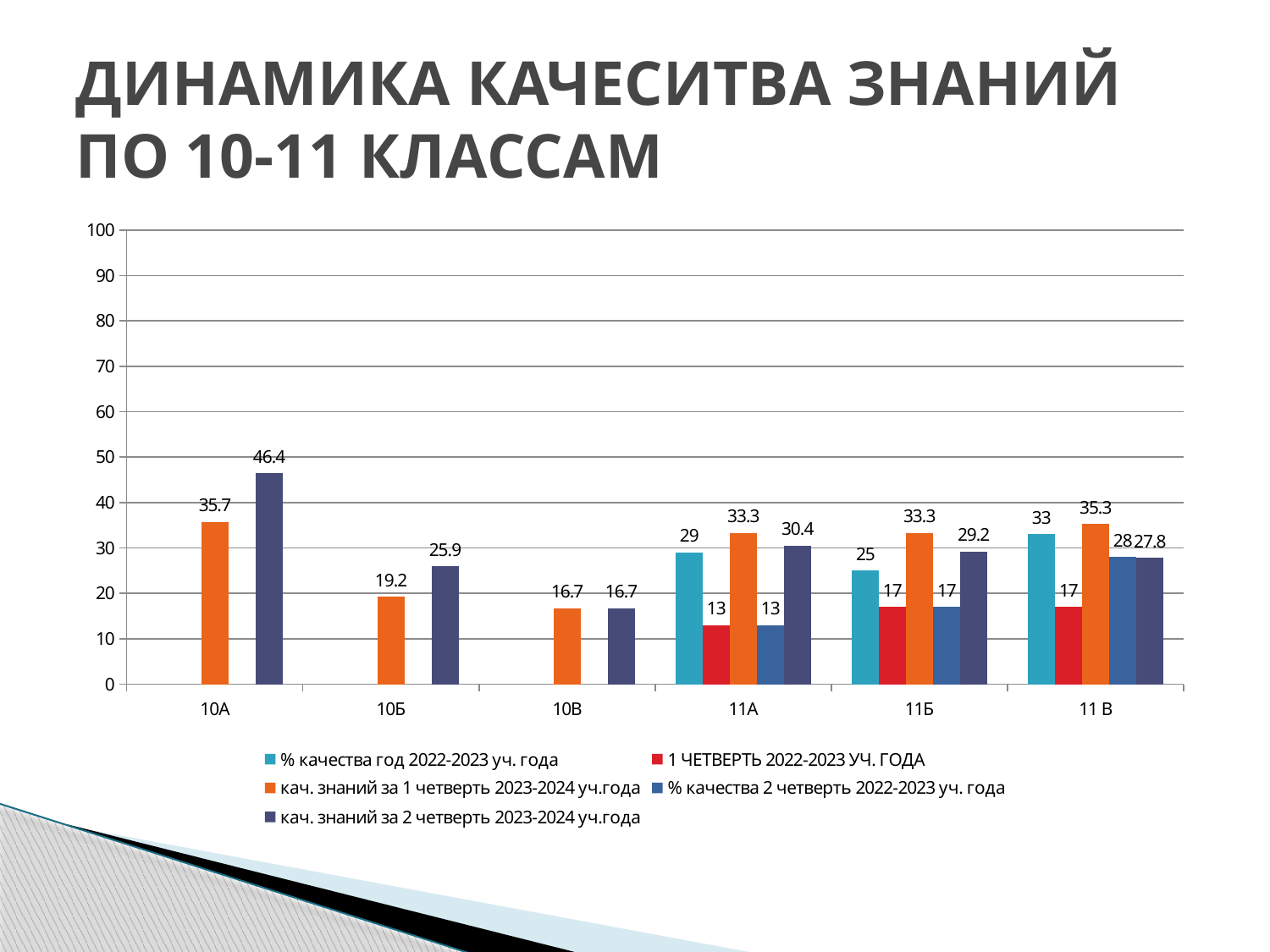
Is the value for 10А in the series 'кач. знаний за 2 четверть 2023-2024 уч.года' greater or less than 40? greater What is the title of the slide? ДИНАМИКА КАЧЕСИТВА ЗНАНИЙ ПО 10-11 КЛАССАМ How many classes are shown on the x axis of the chart? 6 Which class has the lowest value in the series 'кач. знаний за 1 четверть 2023-2024 уч.года'? 10В Which class has the highest value in the series 'кач. знаний за 2 четверть 2023-2024 уч.года'? 10А For 11 В, which is larger: the value for 'кач. знаний за 1 четверть 2023-2024 уч.года' or the value for '% качества год 2022-2023 уч. года'? кач. знаний за 1 четверть 2023-2024 уч.года What is the value for 11А in the series '1 ЧЕТВЕРТЬ 2022-2023 УЧ. ГОДА'? 13 For 10А, what is the difference between the value for 'кач. знаний за 2 четверть 2023-2024 уч.года' and the value for 'кач. знаний за 1 четверть 2023-2024 уч.года'? 10.7 What is the value for 11Б in the series '% качества год 2022-2023 уч. года'? 25 What kind of chart is shown on the slide? bar chart What is the value for 10А in the series 'кач. знаний за 2 четверть 2023-2024 уч.года'? 46.4 How many series does the legend list? 5